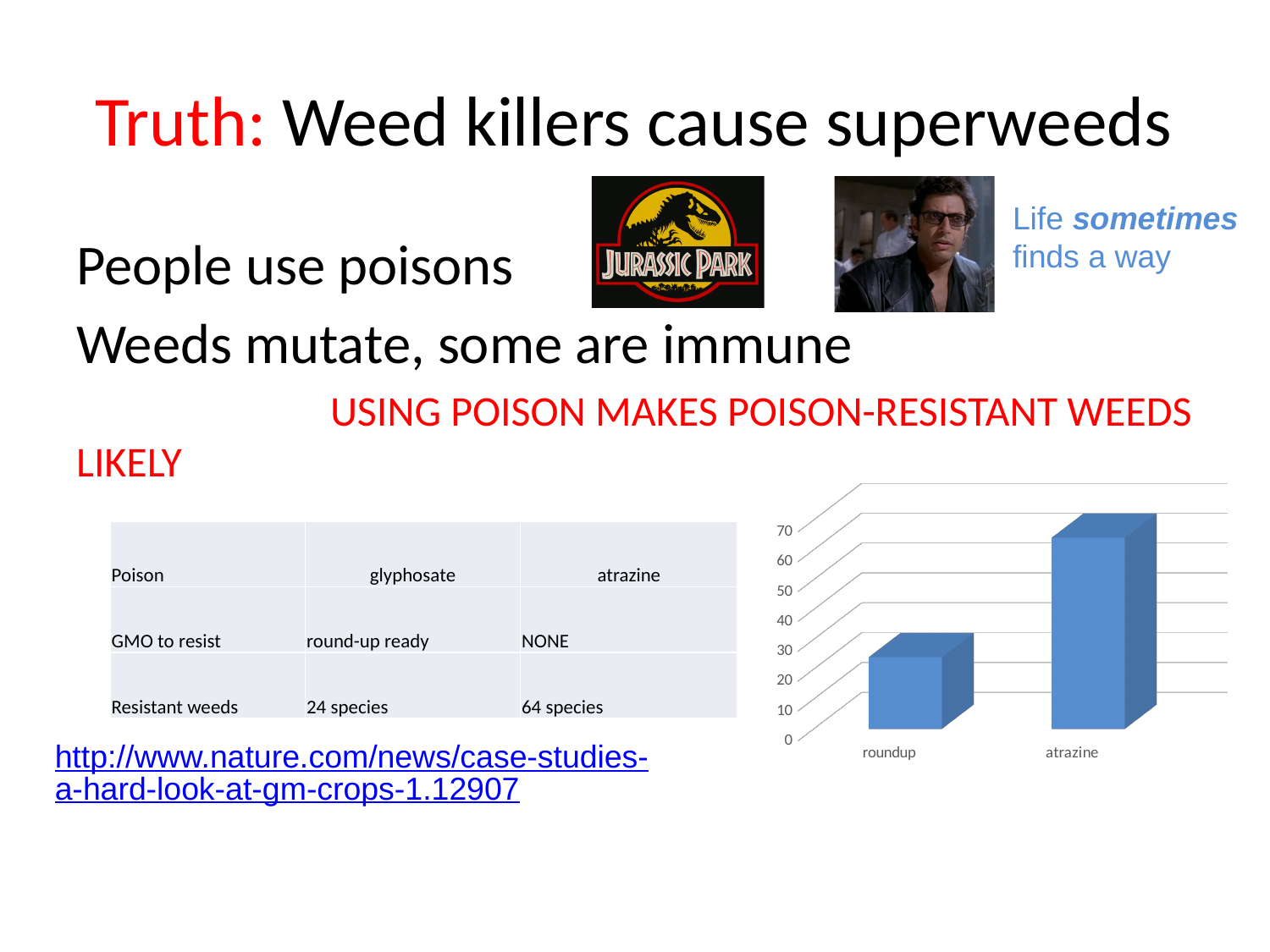
Is the value for atrazine greater or less than 50? greater Which category has the highest bar in the chart? atrazine Is the value for roundup greater or less than 40? less Which is larger in the chart, the value for roundup or the value for atrazine? atrazine What are the two category labels on the chart's x axis? roundup and atrazine Which category has the lowest bar in the chart? roundup Do the bar values rise or fall from roundup to atrazine along the x axis? rise What is the highest tick value shown on the chart's vertical axis? 70 Is the value for roundup greater or less than 10? greater How many categories are shown on the x axis of the chart? 2 What kind of chart is shown on the slide? bar chart